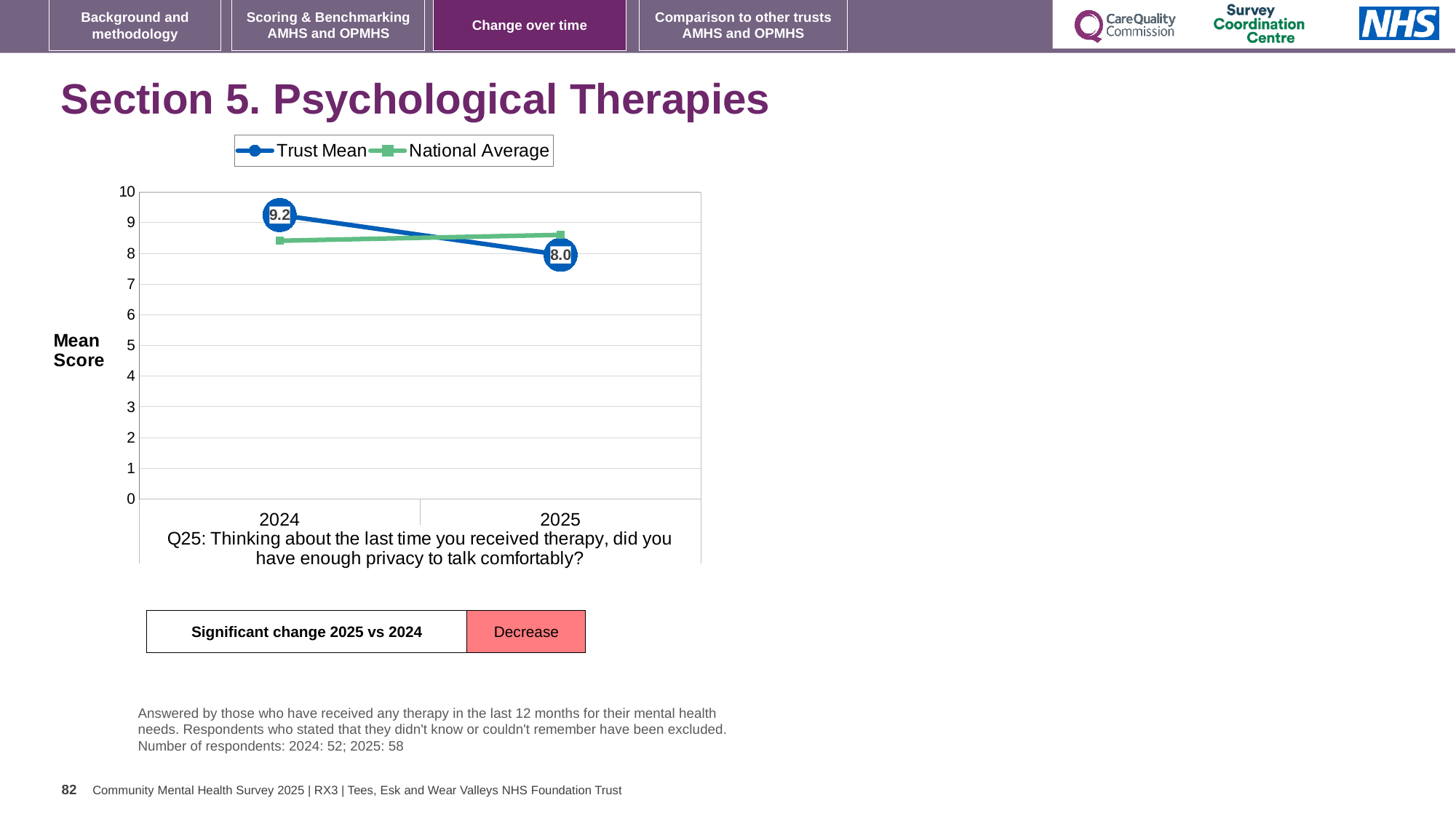
What is the difference between the Trust Mean in 2024 and in 2025? 1.2 Which is larger in 2024, the Trust Mean or the National Average? Trust Mean How many years are shown on the x axis? 2 Is the National Average for 2024 greater or less than 9? less In which year is the Trust Mean lowest? 2025 Does the Trust Mean rise or fall from 2024 to 2025? fall What is the Trust Mean score for 2025? 8.0 What is the Trust Mean score for 2024? 9.2 How many series does the legend list? 2 Is the National Average for 2025 greater or less than 8? greater In which year is the Trust Mean highest? 2024 Which is larger in 2025, the Trust Mean or the National Average? National Average